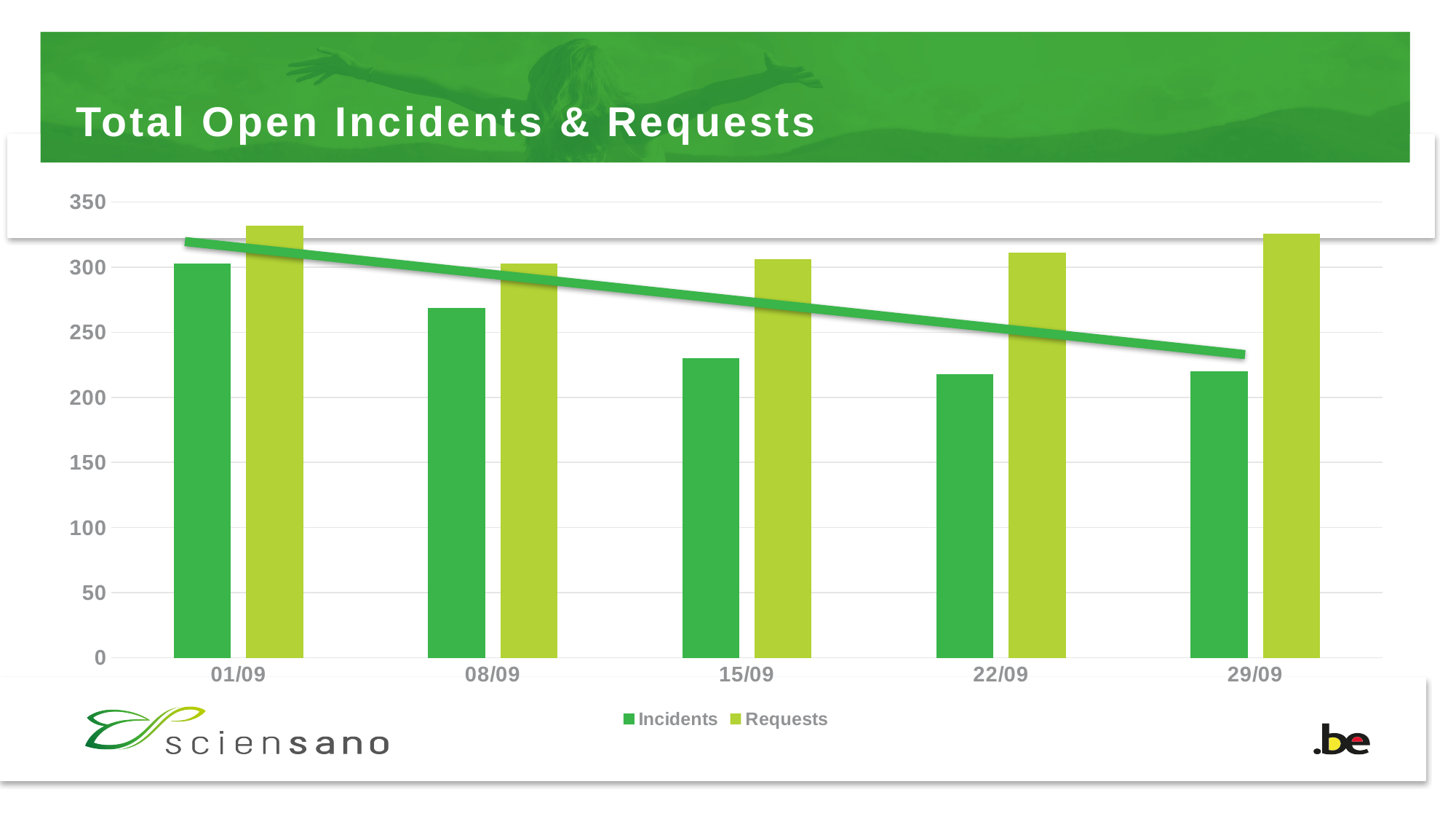
Is the Requests value for 29/09 greater or less than 350? less Do the Incidents values generally rise or fall from 01/09 to 29/09? fall How many series does the chart's legend list? 2 Is the Incidents value for 15/09 greater or less than 250? less On 15/09, which is larger: Incidents or Requests? Requests On which date is the Incidents value highest? 01/09 What is the title of the chart? Total Open Incidents & Requests Is the Incidents value for 08/09 greater or less than 250? greater Which two series are listed in the chart's legend? Incidents and Requests How many dates are shown on the x axis of the chart? 5 What kind of chart is shown on the slide? bar chart